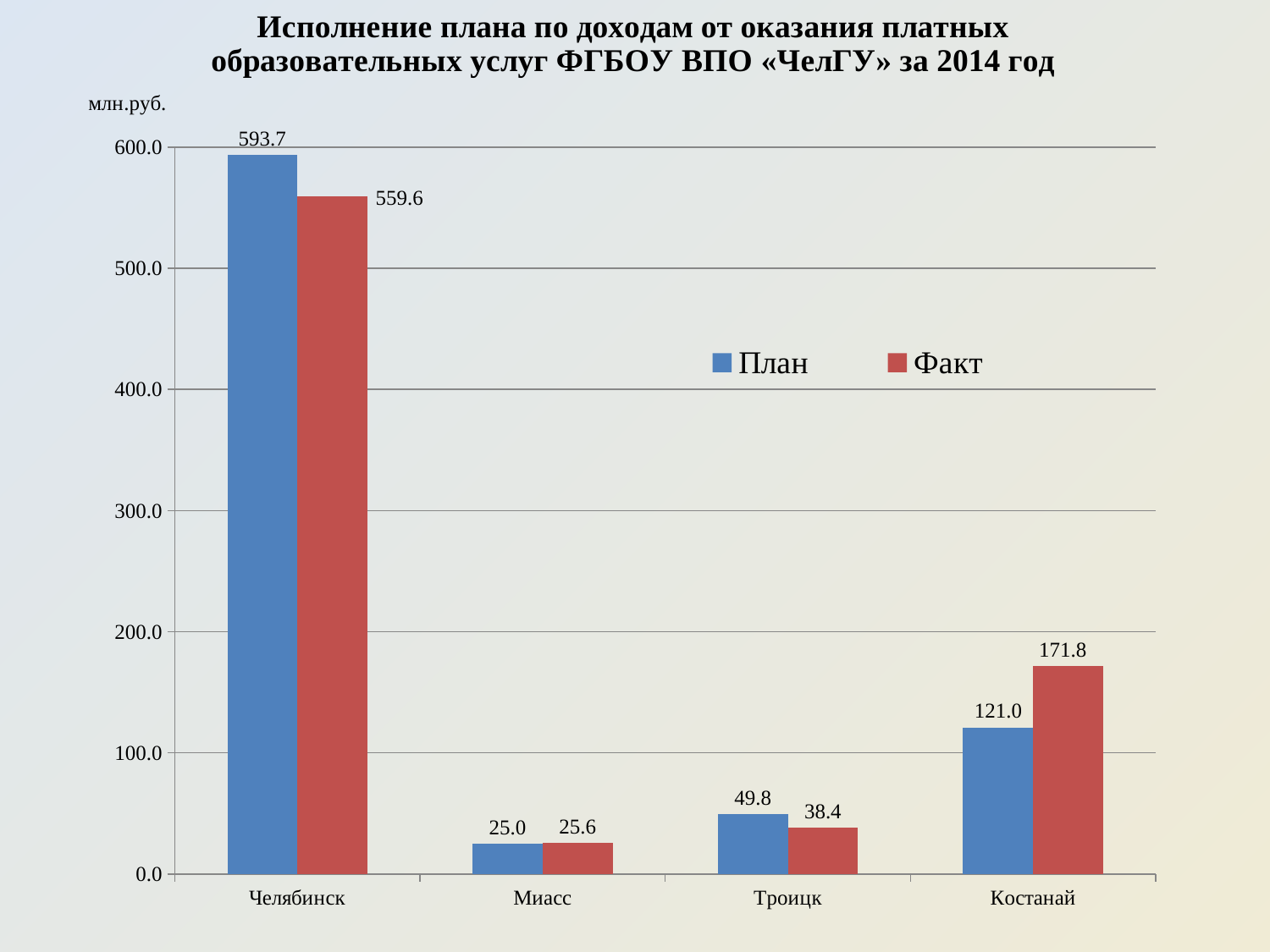
What kind of chart is shown on the slide? bar chart Is the Факт value for Челябинск greater or less than 500.0? greater How many series does the legend list? 2 How many categories are shown on the x axis? 4 What is the Факт value for Костанай? 171.8 What is the difference between the План and Факт values for Челябинск? 34.1 What is the План value for Челябинск? 593.7 Which category has the lowest План value? Миасс What is the Факт value for Троицк? 38.4 Which is larger for Троицк, План or Факт? План What is the difference between the Факт and План values for Костанай? 50.8 Which category has the highest Факт value? Челябинск